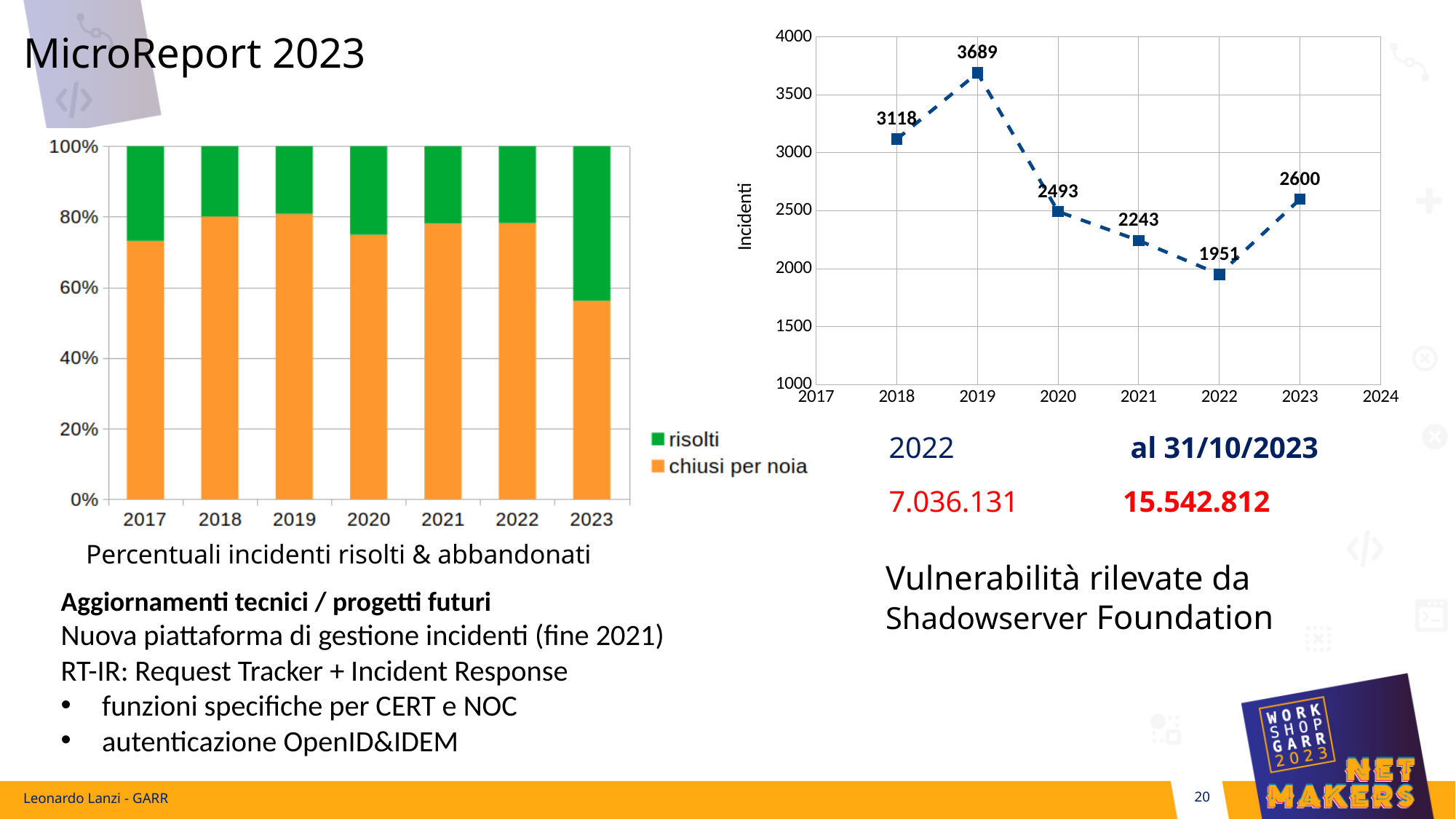
In the line chart on the right, what is the difference between the values for 2019 and 2018? 571 In the line chart on the right, what is the value for 2019? 3689 In the line chart on the right, what is the value for 2022? 1951 In the line chart on the right, which year has the lowest value? 2022 In the bar chart on the left, is the value for 'chiusi per noia' in 2017 greater or less than 60%? greater In the line chart on the right, which year has the highest value? 2019 In the line chart on the right, how many data points are plotted? 6 In the bar chart on the left, how many series does the legend list? 2 In the line chart on the right, what is the difference between the values for 2023 and 2022? 649 What kind of chart is the chart on the left (Percentuali incidenti risolti & abbandonati)? stacked bar chart In the line chart on the right, do the values rise or fall from 2019 to 2022? fall In the bar chart on the left, is the value for 'chiusi per noia' in 2023 greater or less than 60%? less